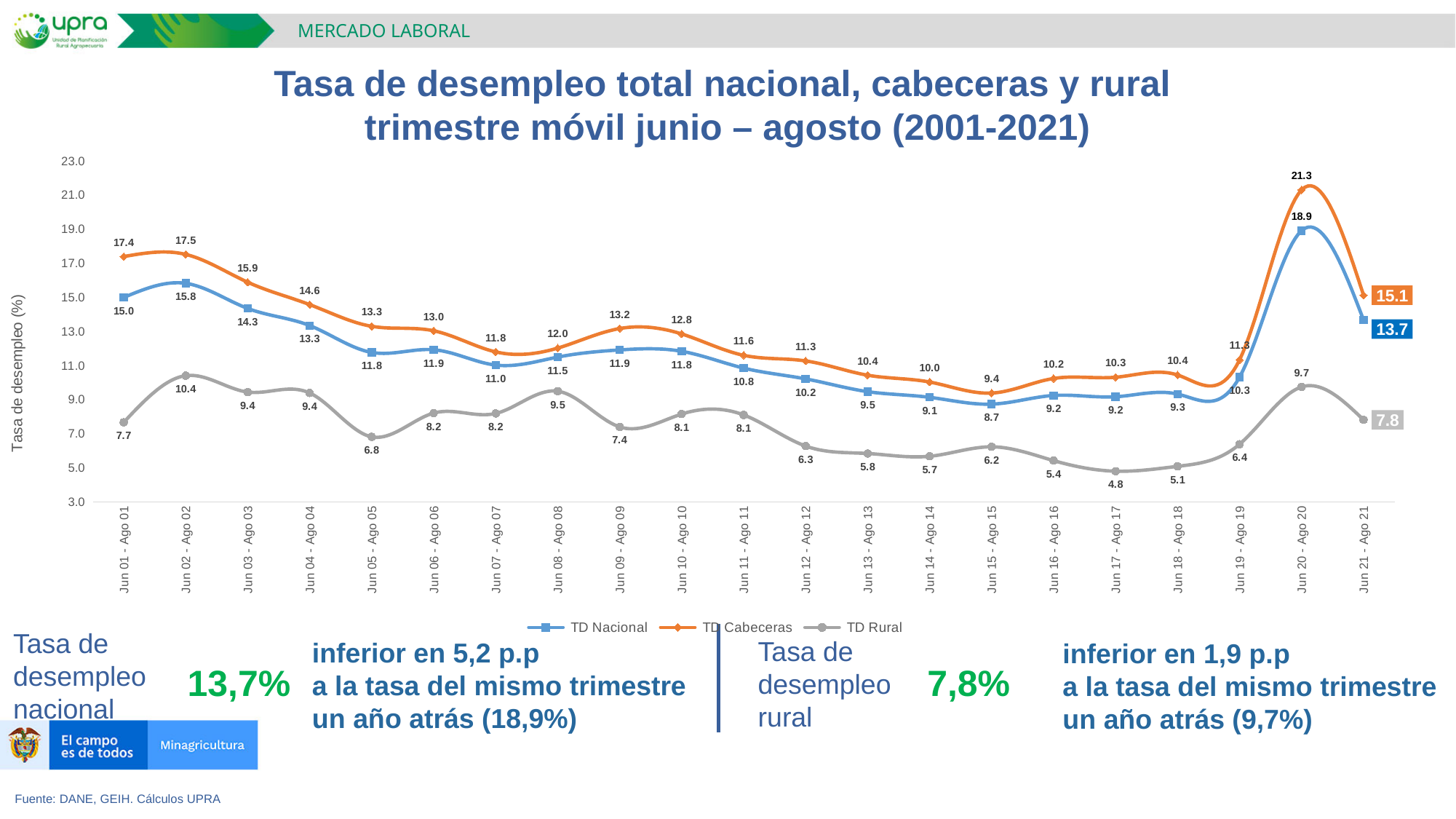
By how much did TD Cabeceras fall from Jun 20 - Ago 20 to Jun 21 - Ago 21? 6.2 How many series does the legend list? 3 What is the value of TD Rural for Jun 17 - Ago 17? 4.8 How many periods are plotted on the x axis? 21 What is the value of TD Nacional for Jun 20 - Ago 20? 18.9 For Jun 02 - Ago 02, which is larger: TD Nacional or TD Rural? TD Nacional Does TD Nacional rise or fall from Jun 10 - Ago 10 to Jun 15 - Ago 15? Fall In which period does TD Cabeceras reach its highest value? Jun 20 - Ago 20 In which period does TD Rural reach its lowest value? Jun 17 - Ago 17 What is the value of TD Cabeceras for Jun 15 - Ago 15? 9.4 What is the title of the vertical axis? Tasa de desempleo (%) What kind of chart is shown on the slide? Line chart